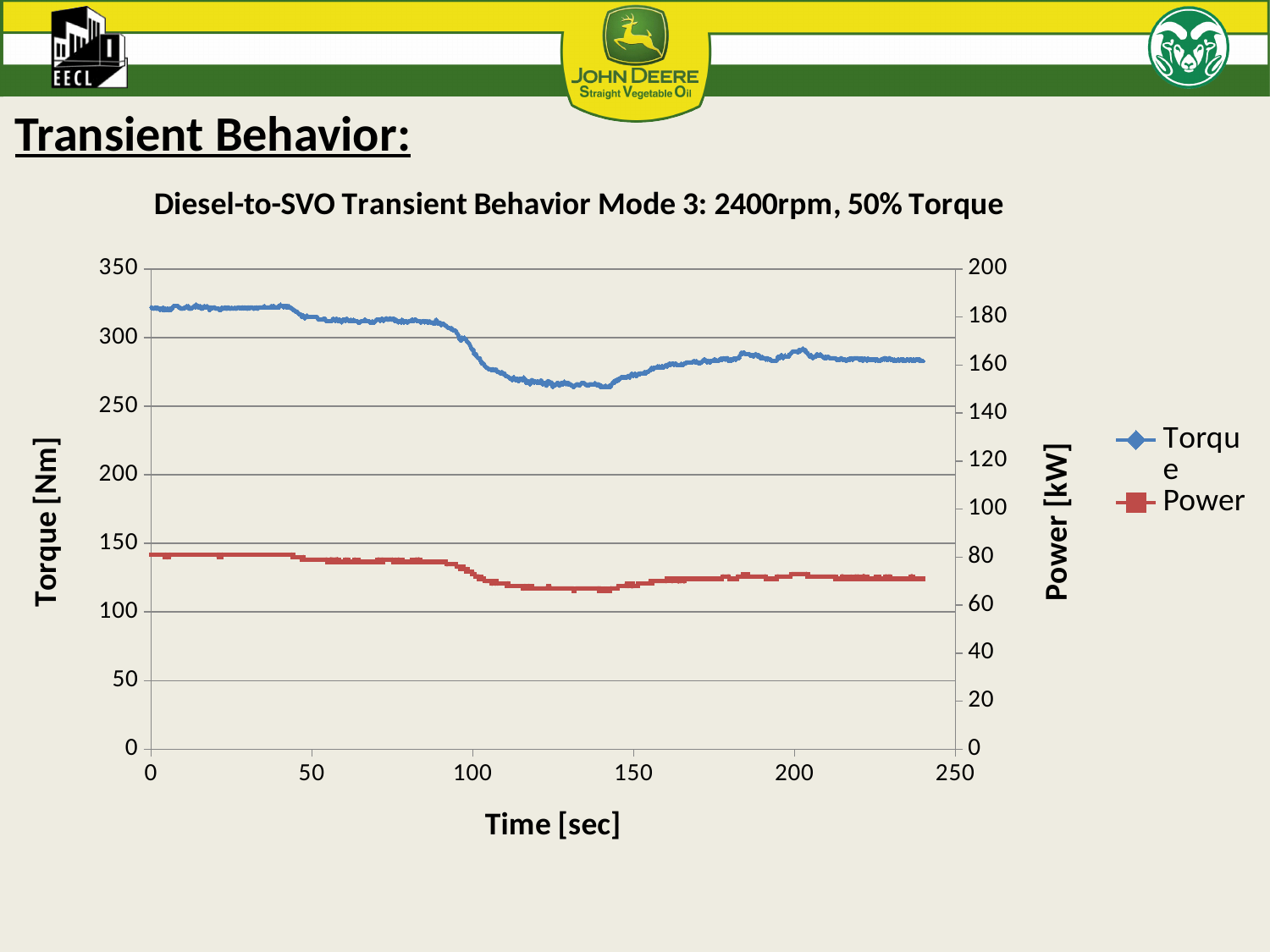
Is the Power value at time 0 sec greater or less than 60 kW? greater What is the title of the chart? Diesel-to-SVO Transient Behavior Mode 3: 2400rpm, 50% Torque Is the Torque value at time 0 sec greater or less than 300 Nm? greater Is the Power value larger at 0 sec or at 130 sec? 0 sec Is the Power value at time 130 sec greater or less than 80 kW? less What is the label of the x axis? Time [sec] Does the Torque series rise or fall between 0 sec and 150 sec? fall What kind of chart is shown on the slide? Line chart How many series does the legend list? 2 Is the Torque value larger at 0 sec or at 130 sec? 0 sec